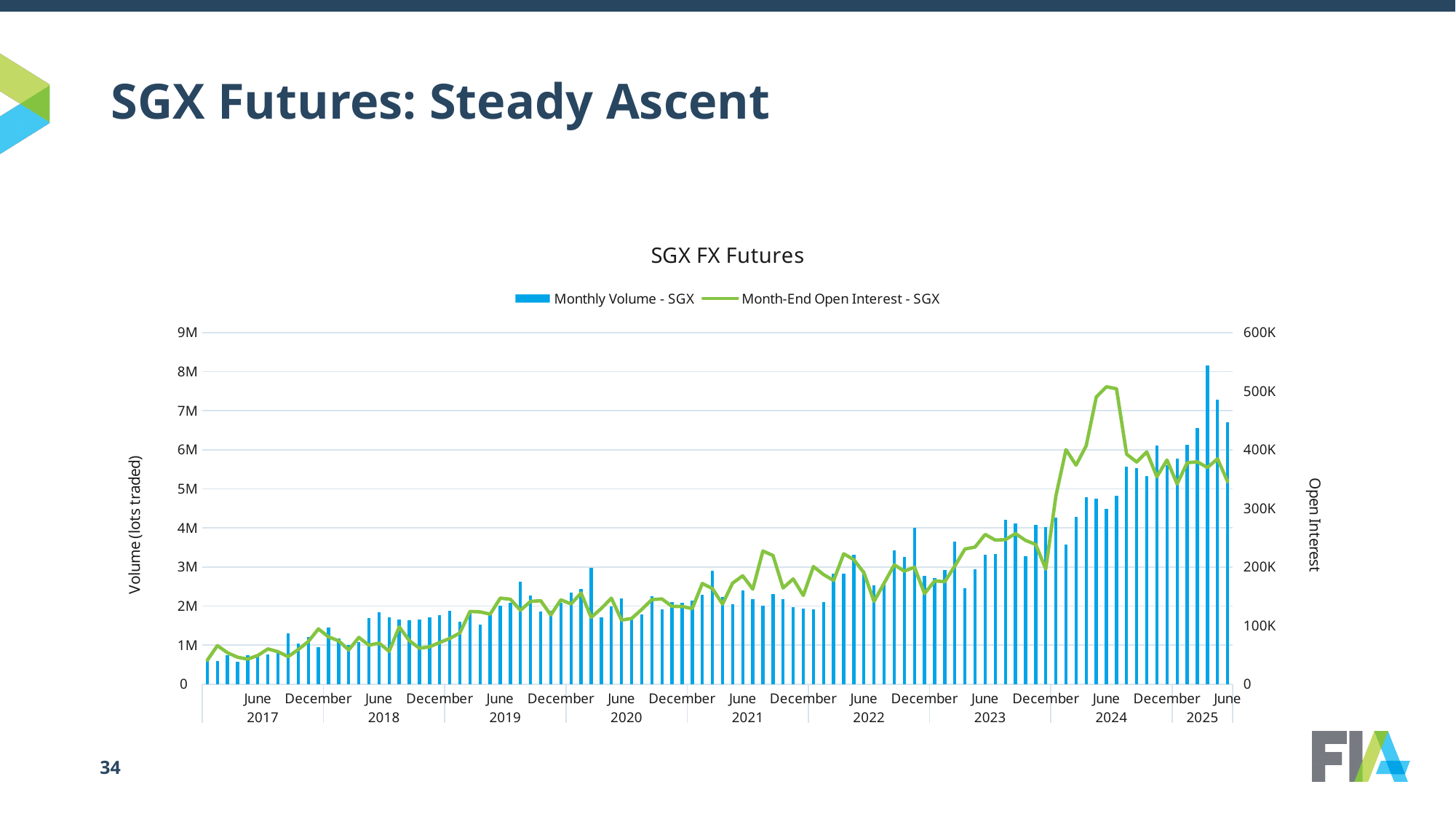
What is the title of the chart on the slide? SGX FX Futures How many series does the chart's legend list? 2 Overall, does Monthly Volume - SGX rise or fall from 2017 to 2025? Rise Is the highest Monthly Volume - SGX bar on the chart greater or less than 7M? greater What kind of chart is used to show Month-End Open Interest - SGX? Line chart Is the Monthly Volume - SGX for June 2025 greater or less than 6M? greater Which is larger, the Monthly Volume - SGX for June 2025 or for June 2017? June 2025 What is the label of the left vertical axis? Volume (lots traded) Is the Monthly Volume - SGX for June 2017 greater or less than 1M? less What kind of chart is used to show Monthly Volume - SGX? Bar chart